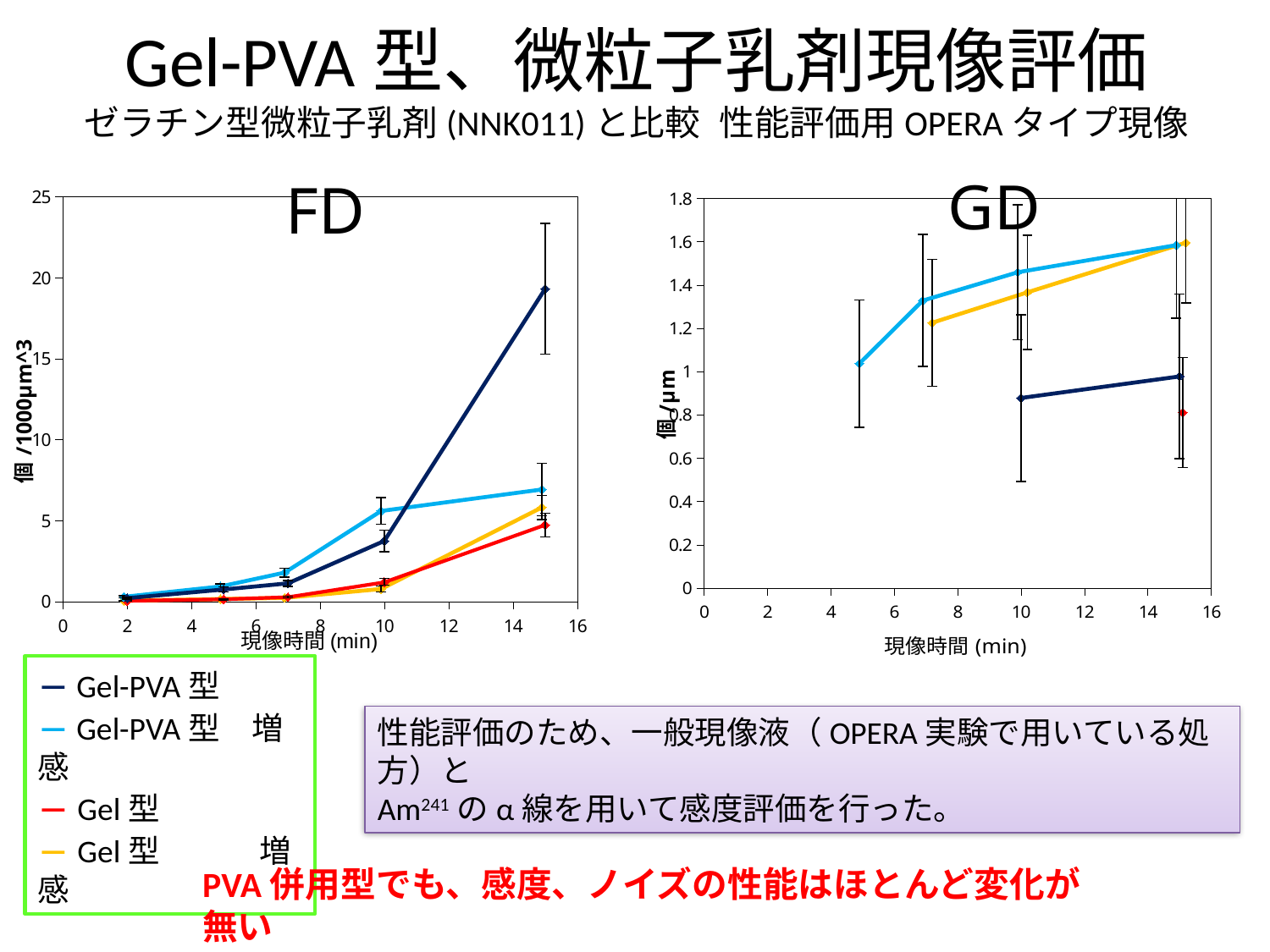
In the FD chart, is the value for Gel-PVA型 at 15 min greater or less than 15? greater In the GD chart at 15 min, which is larger, Gel-PVA型 増感 or Gel-PVA型? Gel-PVA型 増感 In the FD chart, is the value for Gel型 at 10 min greater or less than 5? less In the FD chart at 15 min, which is larger, Gel-PVA型 or Gel型? Gel-PVA型 How many series does the legend list for the charts? 4 What is the x-axis label of the GD chart? 現像時間 (min) In the GD chart, is the value for Gel型 at 15 min greater or less than 1? less In the FD chart, does the Gel-PVA型 series rise or fall as 現像時間 increases? rise What kind of chart is the FD chart on the left? line chart In the FD chart, which series reaches the highest value? Gel-PVA型